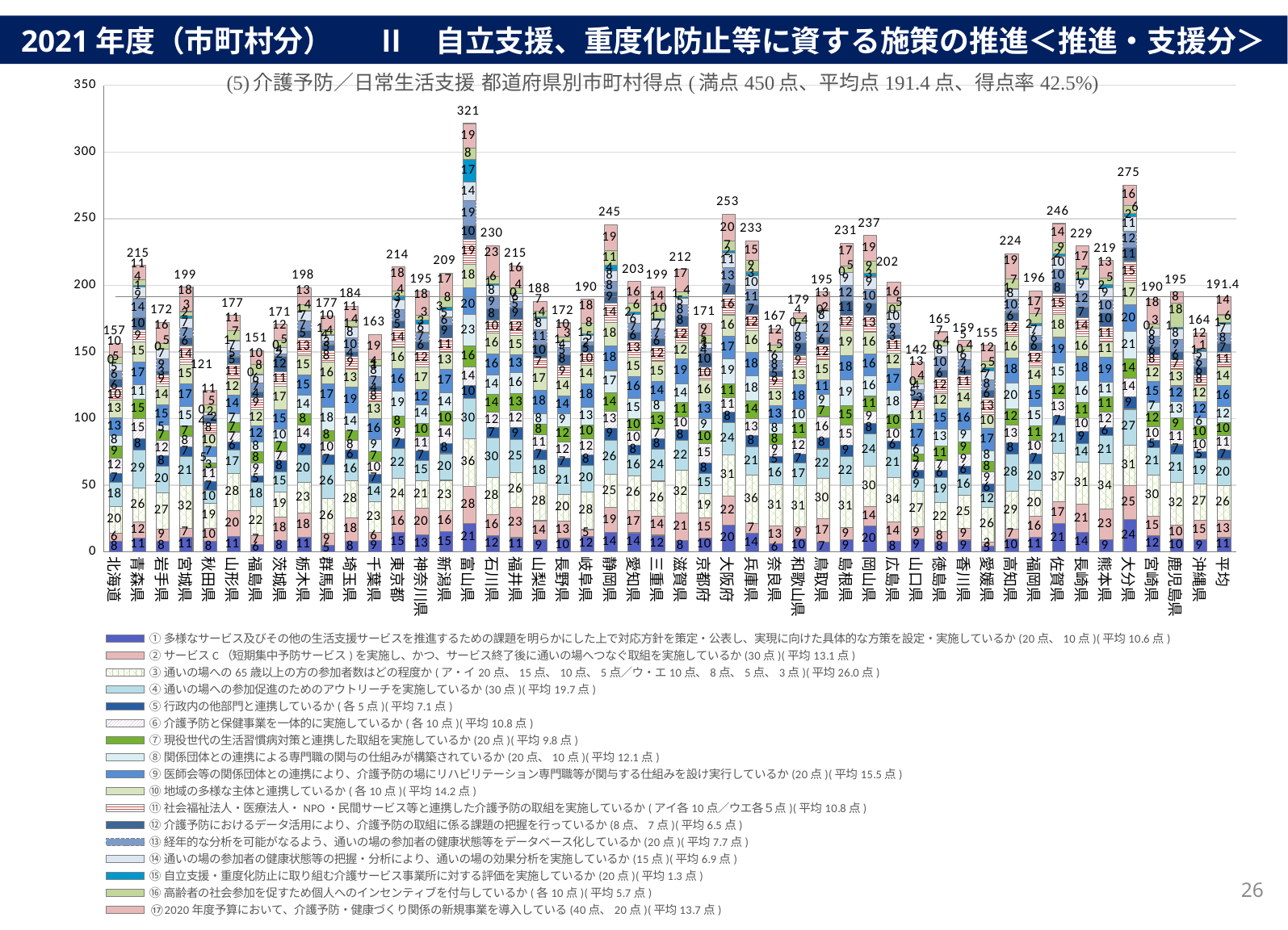
Which prefecture has the lowest total score? 秋田県 How many series does the legend list? 17 According to the chart title, what is the maximum possible score (満点)? 450点 Which prefecture has the highest total score? 富山県 Is the total score for 秋田県 greater or less than 150? less What is the value shown for the 平均 bar? 191.4 What kind of chart is shown on the slide? stacked bar chart What is the difference between the total scores of 富山県 and 秋田県? 200 Which has a higher total score, 大分県 or 大阪府? 大分県 What is the total score for 大分県? 275 What is the total score for 富山県? 321 What is the difference between the total scores of 大阪府 and 兵庫県? 20